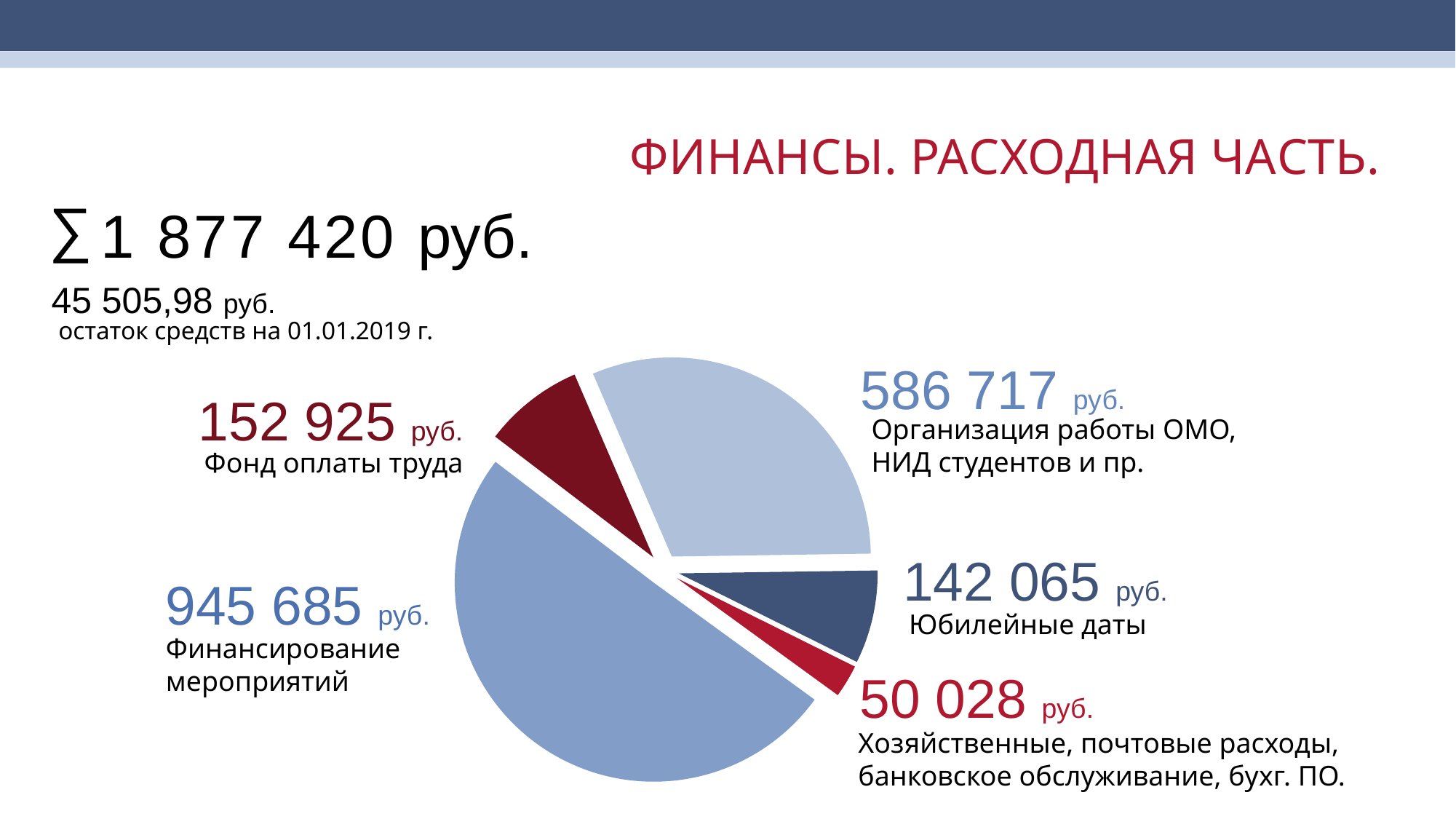
Which is larger: Фонд оплаты труда or Юбилейные даты? Фонд оплаты труда Which category has the largest slice of the pie? Финансирование мероприятий What is the value for Финансирование мероприятий? 945 685 руб. What is the value for Юбилейные даты? 142 065 руб. What is the value for Организация работы ОМО, НИД студентов и пр.? 586 717 руб. What kind of chart is shown on the slide? Pie chart How many slices does the pie chart have? 5 What is the value for Фонд оплаты труда? 152 925 руб. What is the difference between Финансирование мероприятий and Организация работы ОМО, НИД студентов и пр.? 358 968 руб. What is the total of all expenses shown on the slide? 1 877 420 руб. Which category has the smallest slice of the pie? Хозяйственные, почтовые расходы, банковское обслуживание, бухг. ПО. What is the title of the slide? ФИНАНСЫ. РАСХОДНАЯ ЧАСТЬ.